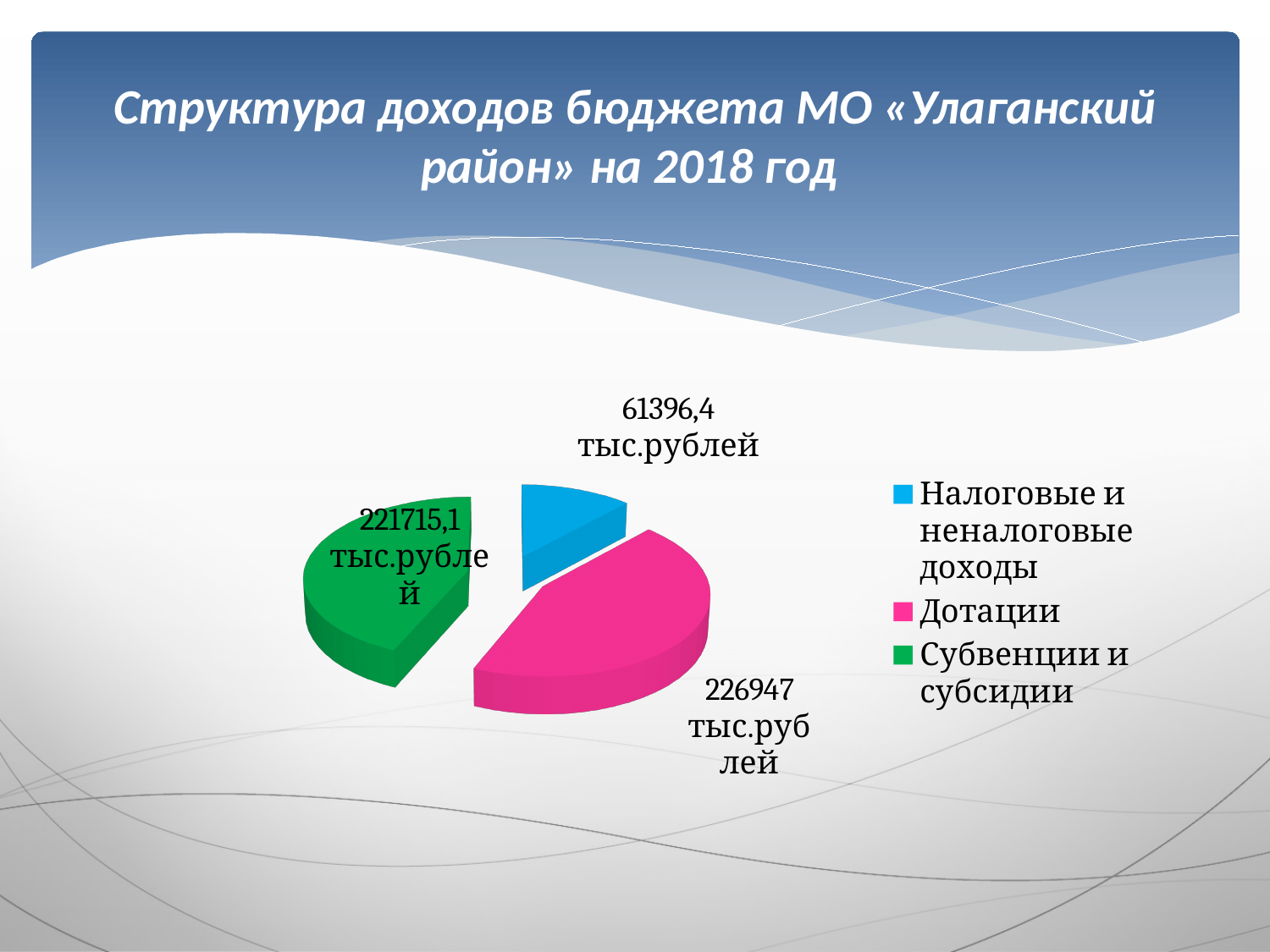
Which category has the largest value in the pie chart? Дотации What is the value shown for Субвенции и субсидии? 221715,1 тыс.рублей Which category has the smallest value in the pie chart? Налоговые и неналоговые доходы What is the difference between the values for Дотации and Субвенции и субсидии? 5231,9 тыс.рублей How many slices does the pie chart have? 3 Which is larger: Дотации or Субвенции и субсидии? Дотации How many entries does the legend of the pie chart list? 3 What colour is the slice for Субвенции и субсидии? Green What type of chart is shown on the slide? Pie chart What is the value shown for Налоговые и неналоговые доходы? 61396,4 тыс.рублей What is the difference between the values for Дотации and Налоговые и неналоговые доходы? 165550,6 тыс.рублей What is the value shown for Дотации? 226947 тыс.рублей